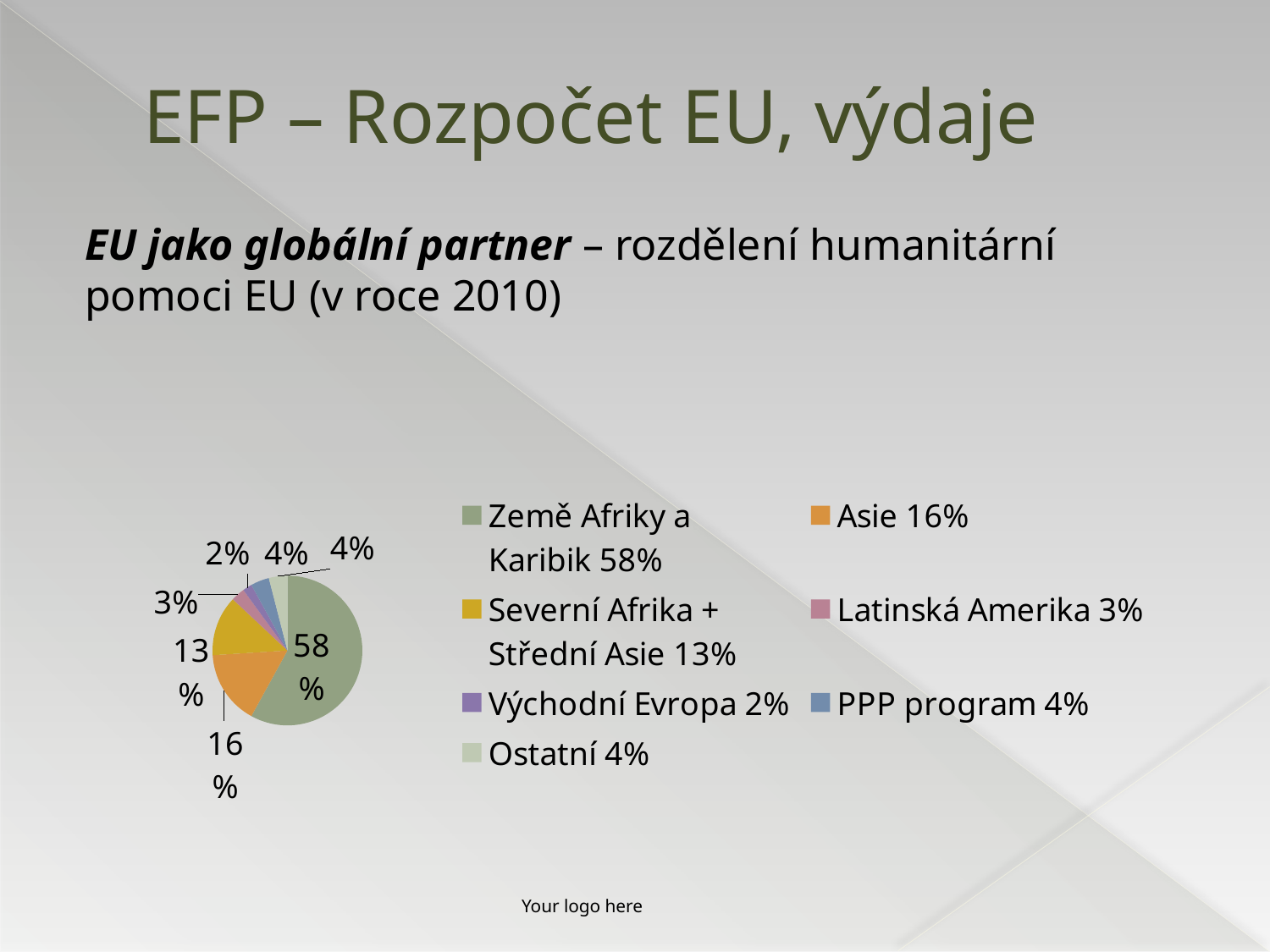
How many entries does the legend list? 7 What is the difference between the shares of Asie and Severní Afrika + Střední Asie? 3% What share of the pie does Latinská Amerika have? 3% What share of the pie does Asie have? 16% What share of the pie does Severní Afrika + Střední Asie have? 13% Which category has the smallest slice of the pie? Východní Evropa Which is larger, the share of Latinská Amerika or the share of PPP program? PPP program Which category has the largest slice of the pie? Země Afriky a Karibik How many slices does the pie chart have? 7 What kind of chart is shown on the slide? pie chart